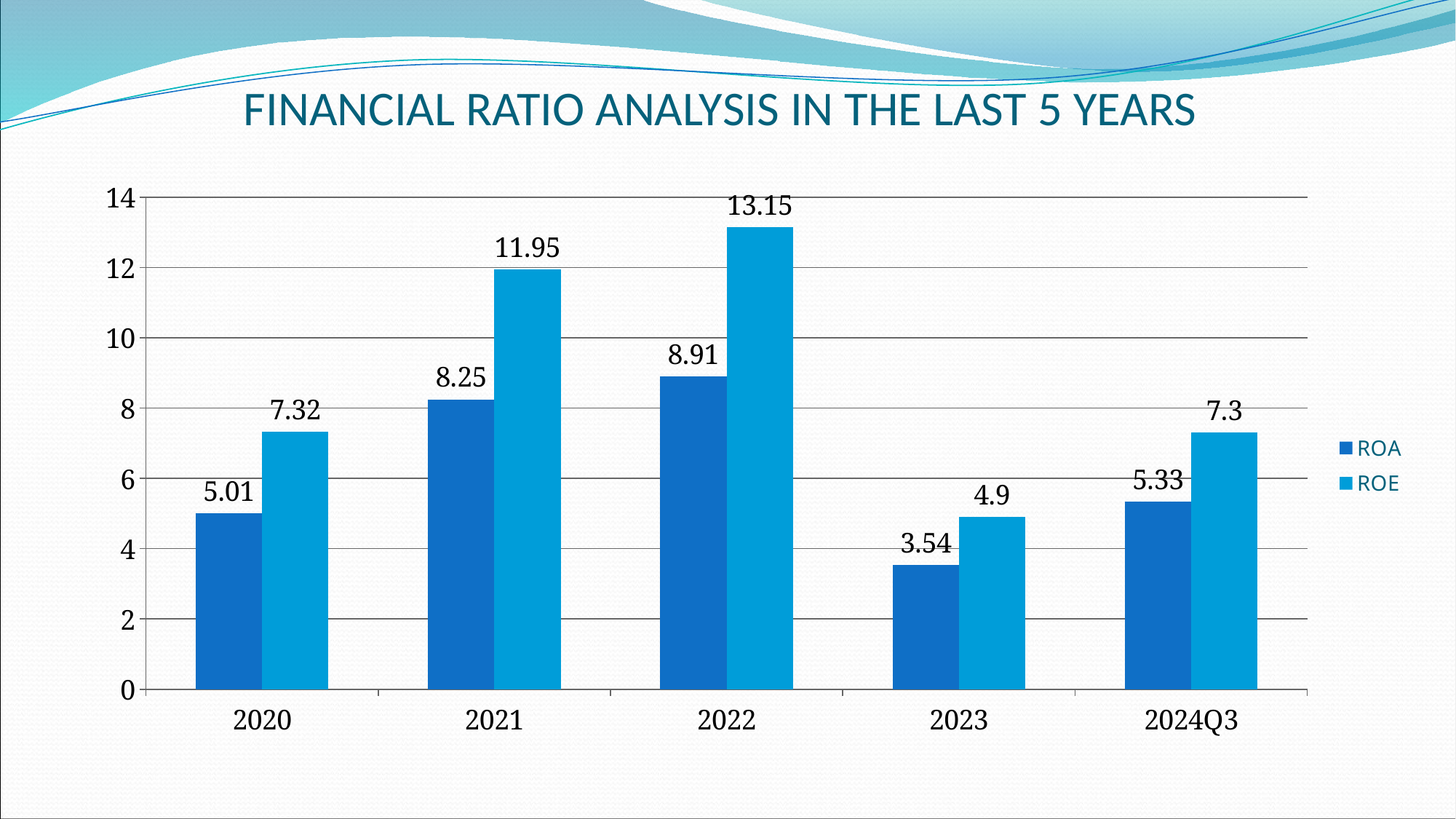
What is the ROA value for 2024Q3? 5.33 What is the title of the chart? FINANCIAL RATIO ANALYSIS IN THE LAST 5 YEARS What kind of chart is shown on the slide? bar chart Which is larger, ROE in 2020 or ROE in 2024Q3? ROE in 2020 In which year is ROE highest? 2022 What is the difference between ROE and ROA in 2021? 3.7 Is the ROE value for 2023 greater or less than 6? less How many periods are shown on the x axis? 5 In which year is ROA lowest? 2023 How many series does the legend list? 2 What is the ROA value for 2022? 8.91 What is the ROE value for 2020? 7.32